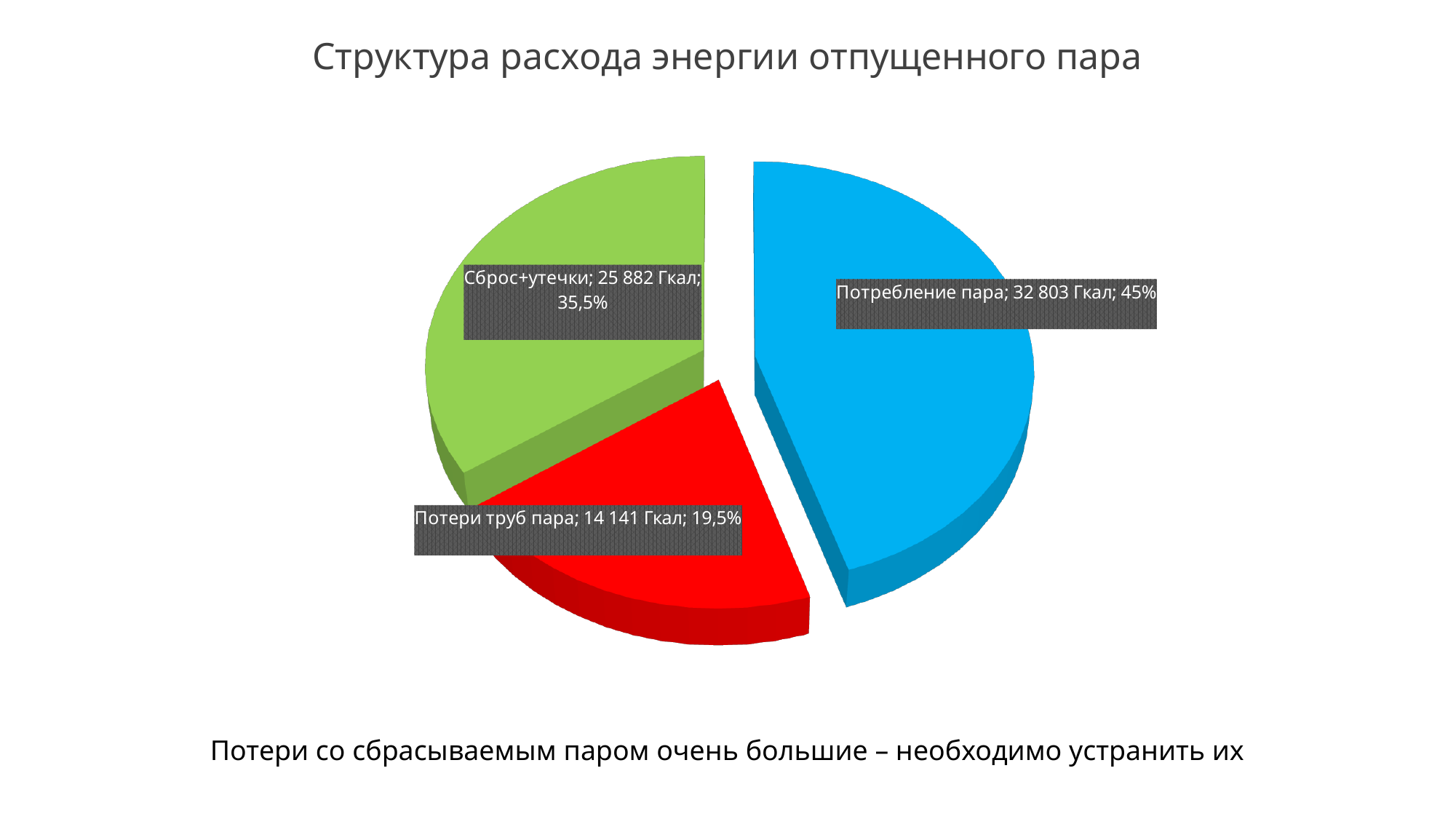
What share of the pie does Потери труб пара represent? 19,5% What is the value for Потери труб пара? 14 141 Гкал Which is larger, Сброс+утечки or Потери труб пара? Сброс+утечки What is the difference in Гкал between Потребление пара and Сброс+утечки? 6 921 Гкал Which category has the largest slice? Потребление пара What type of chart is shown on the slide? Pie chart What is the value for Сброс+утечки? 25 882 Гкал What is the title of the chart? Структура расхода энергии отпущенного пара How many slices does the pie chart have? 3 What share of the pie does Сброс+утечки represent? 35,5% Which category has the smallest slice? Потери труб пара What is the value for Потребление пара? 32 803 Гкал